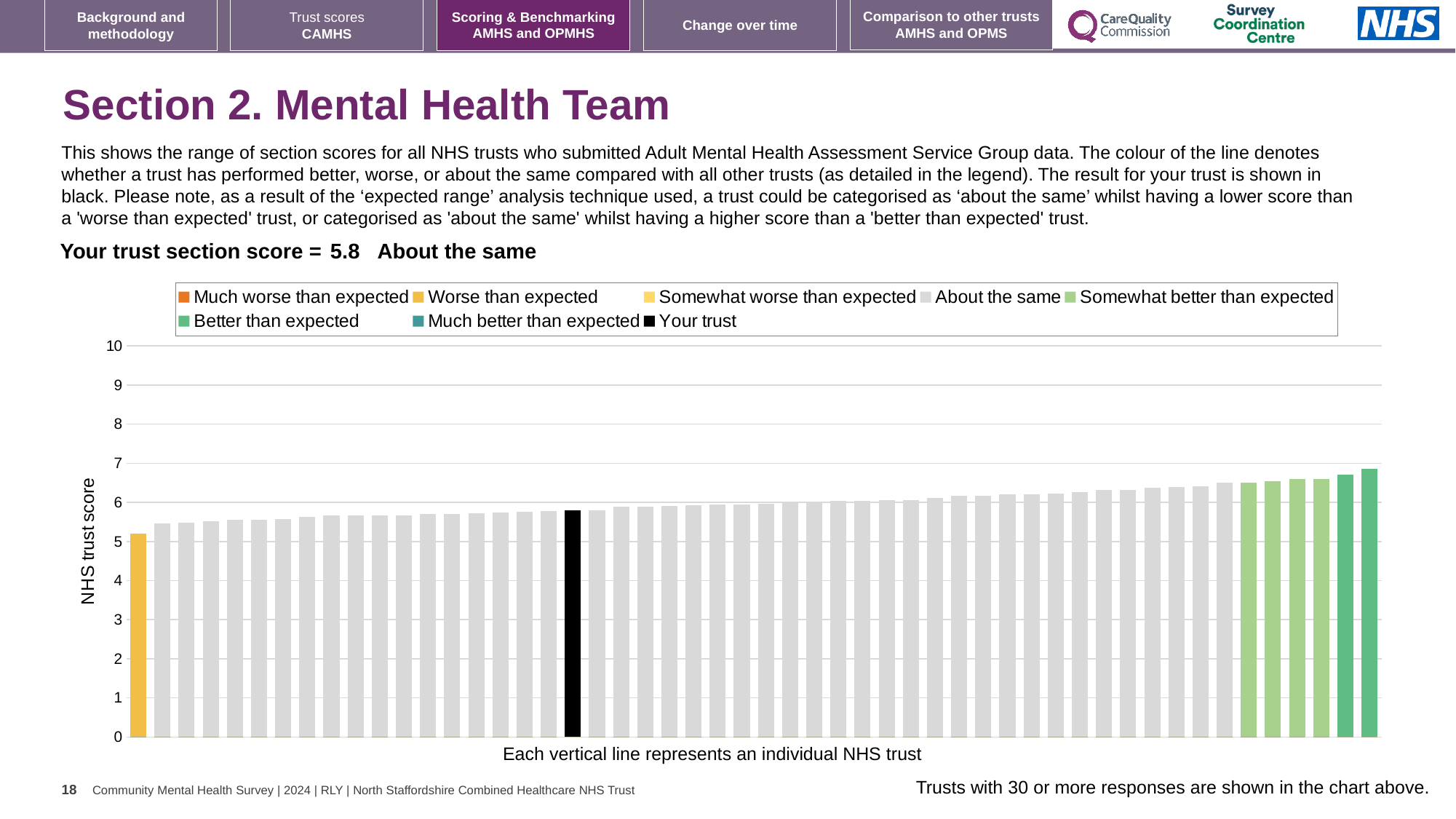
What kind of chart is shown on the slide? bar chart Do the bar values rise or fall from left to right along the x axis? rise What is the label on the vertical axis of the chart? NHS trust score How many bars are shown in the 'Worse than expected' colour? 1 Is the value of the tallest bar on the right of the chart greater or less than 7? less Is the black 'Your trust' bar higher or lower than the leftmost yellow bar? higher Is the value of the black 'Your trust' bar greater or less than 6? less Is the value of the leftmost bar greater or less than 6? less What is the section score for your trust shown on the slide? 5.8 How many entries does the chart legend list? 8 What colour is the bar representing your trust? black